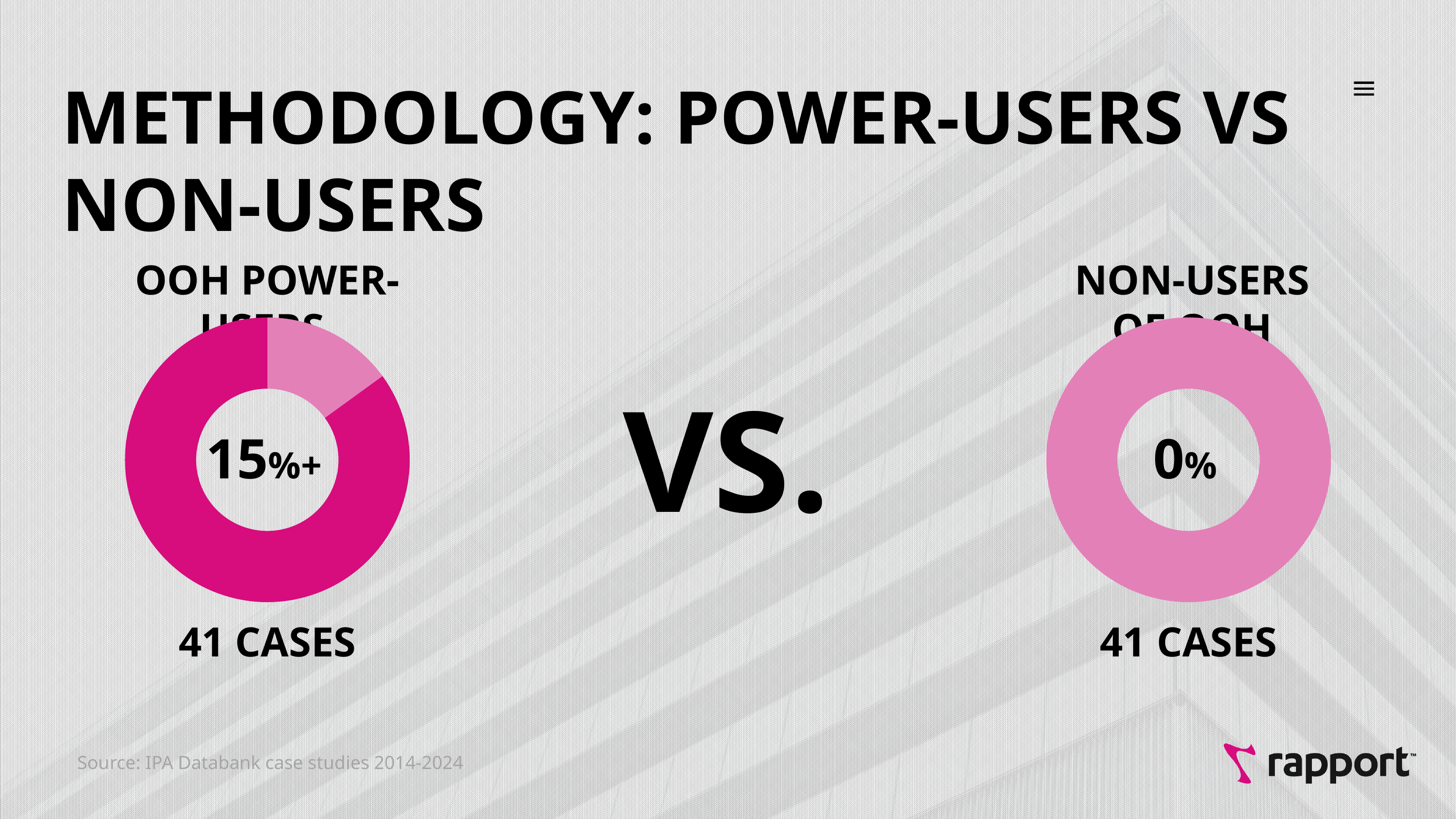
How many cases does the OOH power-users chart on the left represent? 41 cases In the OOH power-users donut chart on the left, which segment is larger, the dark magenta one or the light pink one? The dark magenta one What value is printed in the centre of the OOH power-users donut chart? 15%+ What kind of chart is used for the non-users of OOH group on the right? Donut chart How many cases does the non-users of OOH chart on the right represent? 41 cases What source is cited at the bottom of the slide? IPA Databank case studies 2014-2024 How many donut charts are shown on the slide? 2 Which group has the larger value printed in the centre of its donut chart, OOH power-users or non-users of OOH? OOH power-users What value is printed in the centre of the non-users of OOH donut chart? 0% What is the title of the slide? Methodology: Power-users vs non-users How many distinct coloured segments does the OOH power-users donut chart on the left have? 2 What kind of chart is used for the OOH power-users group on the left? Donut chart